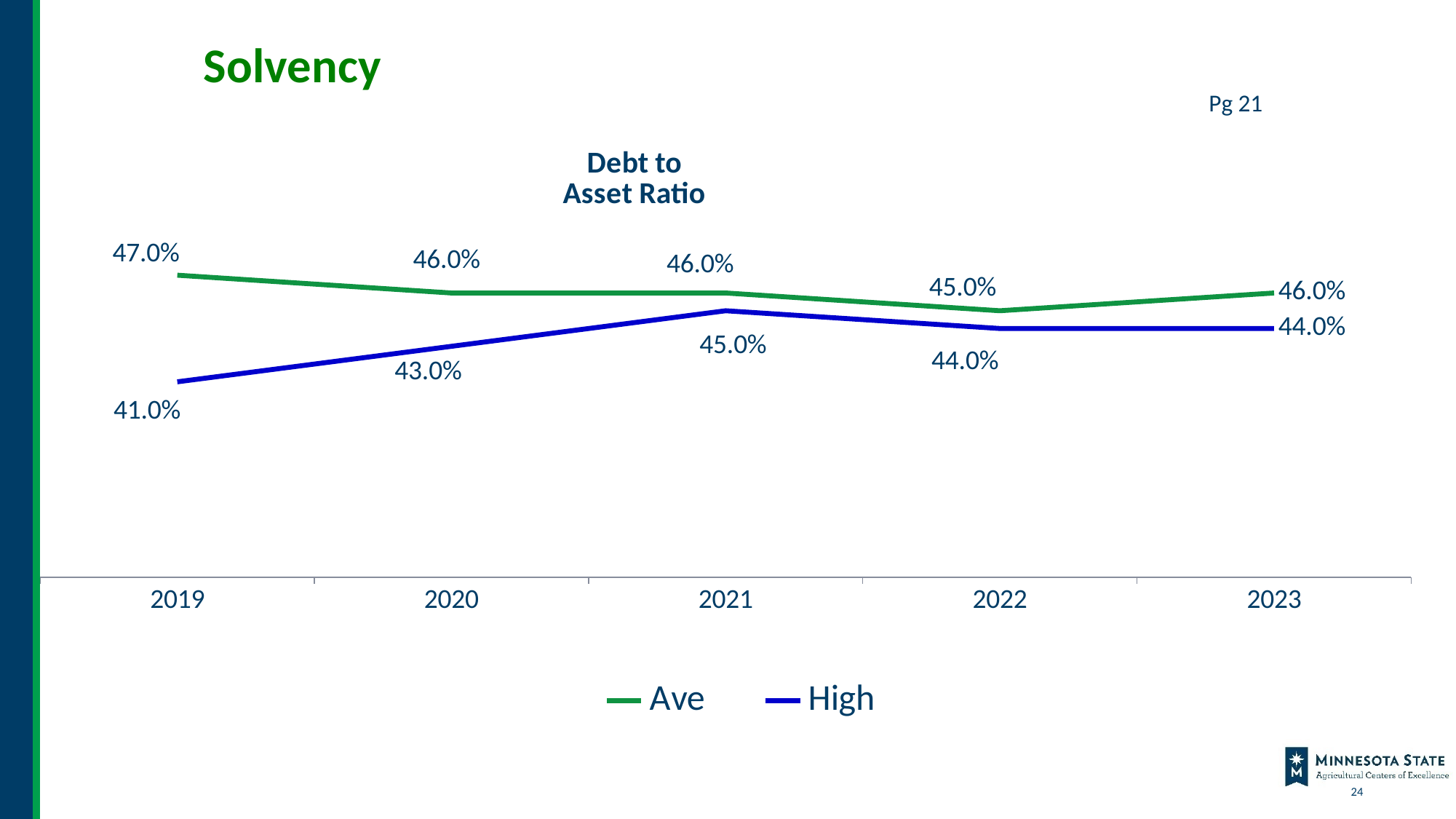
How many series does the legend list? 2 What is the High value for 2019? 41.0% What is the Ave value for 2022? 45.0% What is the Ave value for 2019 in the Debt to Asset Ratio chart? 47.0% How many years are shown on the x axis? 5 In which year is the Ave series at its highest? 2019 Which is larger in 2023, the Ave value or the High value? Ave What kind of chart is shown on the slide? Line chart What is the High value for 2021 in the Debt to Asset Ratio chart? 45.0% In which year is the High series at its lowest? 2019 Does the High series rise or fall from 2019 to 2021? Rise What is the difference between the Ave and High values in 2019? 6.0%